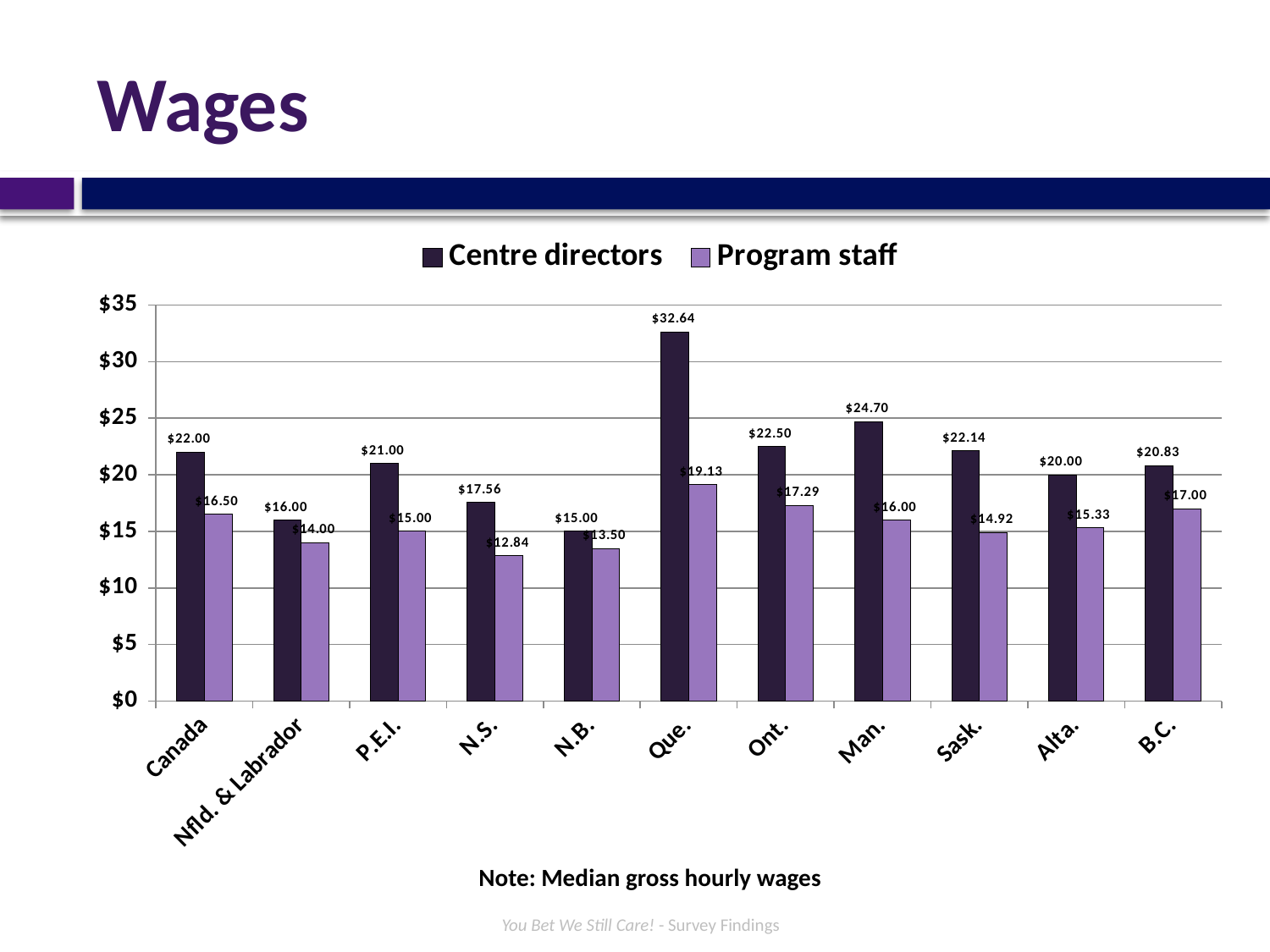
What is the median gross hourly wage for Centre directors in Que.? $32.64 What kind of chart is shown on the slide? bar chart Is the Program staff wage in Que. greater or less than $20? less Which province or region has the highest Centre directors wage? Que. What is the value for Program staff in N.S.? $12.84 Which province or region has the lowest Program staff wage? N.S. Which is larger: the Centre directors wage in Sask. or the Centre directors wage in Alta.? Sask. What does the note below the chart say the values represent? Median gross hourly wages How many provinces or regions are shown on the x axis? 11 What is the difference between the Centre directors and Program staff wages in Man.? $8.70 What is the median gross hourly wage for Program staff in Ont.? $17.29 How many series does the legend list? 2